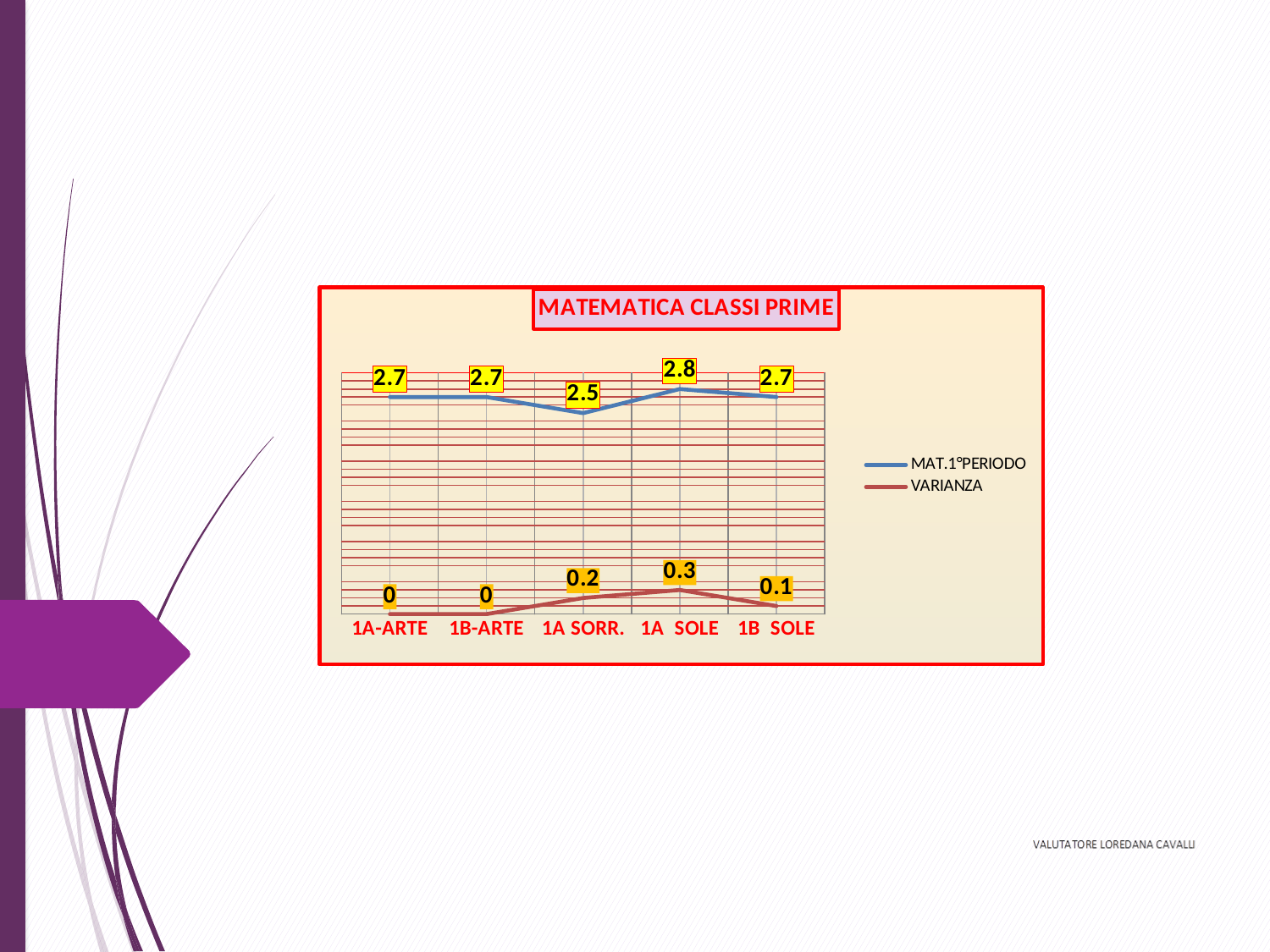
What kind of chart is shown? line chart What is the VARIANZA value for 1A SOLE? 0.3 What is the difference between the MAT.1°PERIODO values for 1A SOLE and 1A SORR.? 0.3 Which category has the highest VARIANZA value? 1A SOLE Which category has the highest MAT.1°PERIODO value? 1A SOLE How many series does the legend list? 2 How many categories are shown on the x axis? 5 Which is larger, the VARIANZA for 1A SORR. or for 1B SOLE? 1A SORR. What is the title of the chart? MATEMATICA CLASSI PRIME What is the MAT.1°PERIODO value for 1A SORR.? 2.5 Which category has the lowest MAT.1°PERIODO value? 1A SORR. What is the VARIANZA value for 1B SOLE? 0.1